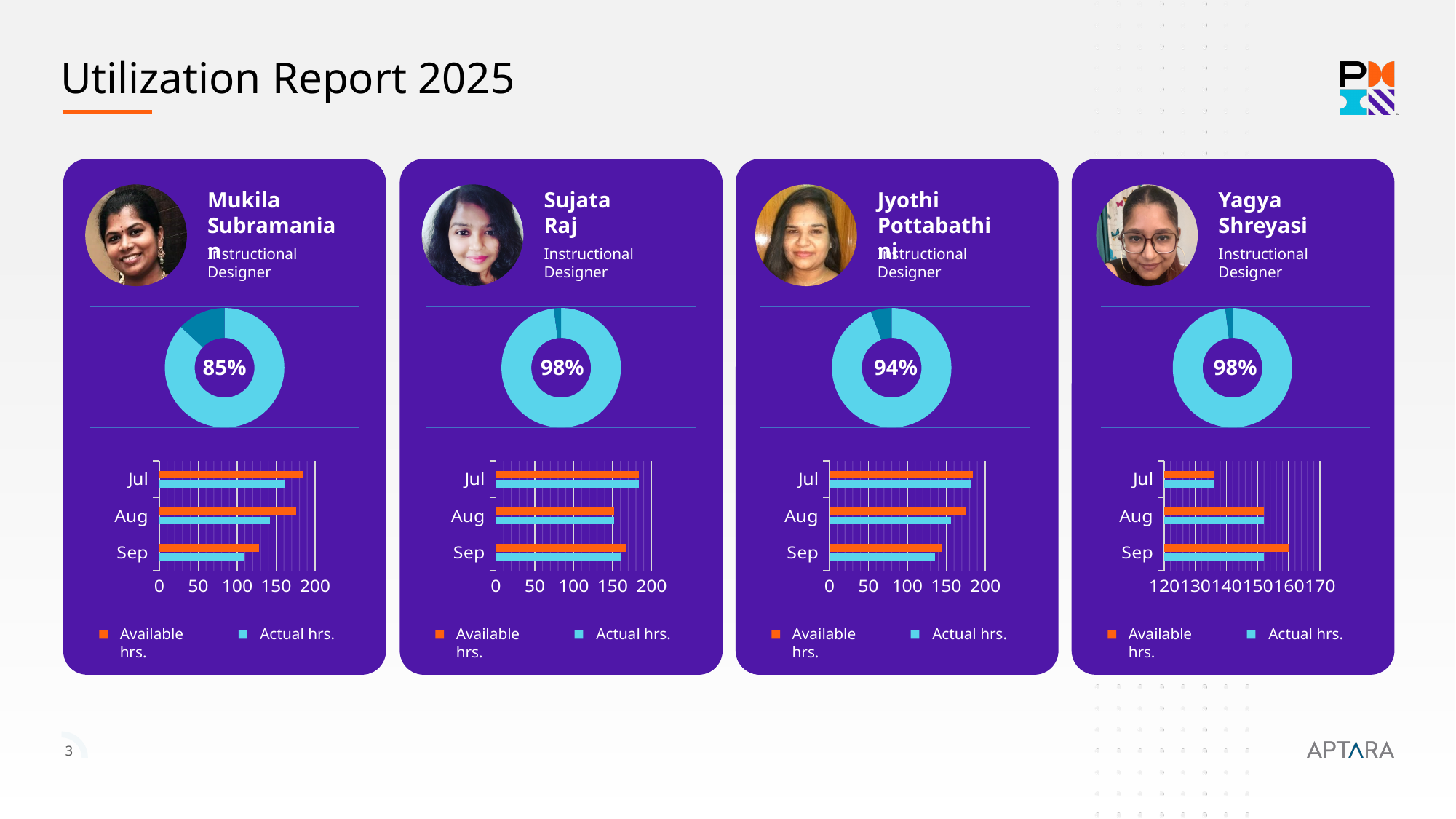
On Mukila Subramanian's card, what utilization percentage does the donut chart show? 85% How many series does the legend list on the bar chart in Sujata Raj's card? 2 How many months are shown on the bar chart in Mukila Subramanian's card? 3 What is the difference between Sujata Raj's and Mukila Subramanian's donut chart percentages? 13% On Mukila Subramanian's bar chart, is the Available hrs. value for Sep greater or less than 150? less What kind of chart is shown below the donut on Jyothi Pottabathini's card? Bar chart On the bar charts, which colour represents Actual hrs.? Blue On Mukila Subramanian's bar chart, which is larger for Jul: Available hrs. or Actual hrs.? Available hrs. Across the four donut charts, which person has the lowest utilization percentage? Mukila Subramanian On Mukila Subramanian's bar chart, do the Available hrs. values rise or fall from Jul to Sep? Fall On Jyothi Pottabathini's card, what utilization percentage does the donut chart show? 94% On Sujata Raj's card, what utilization percentage does the donut chart show? 98%